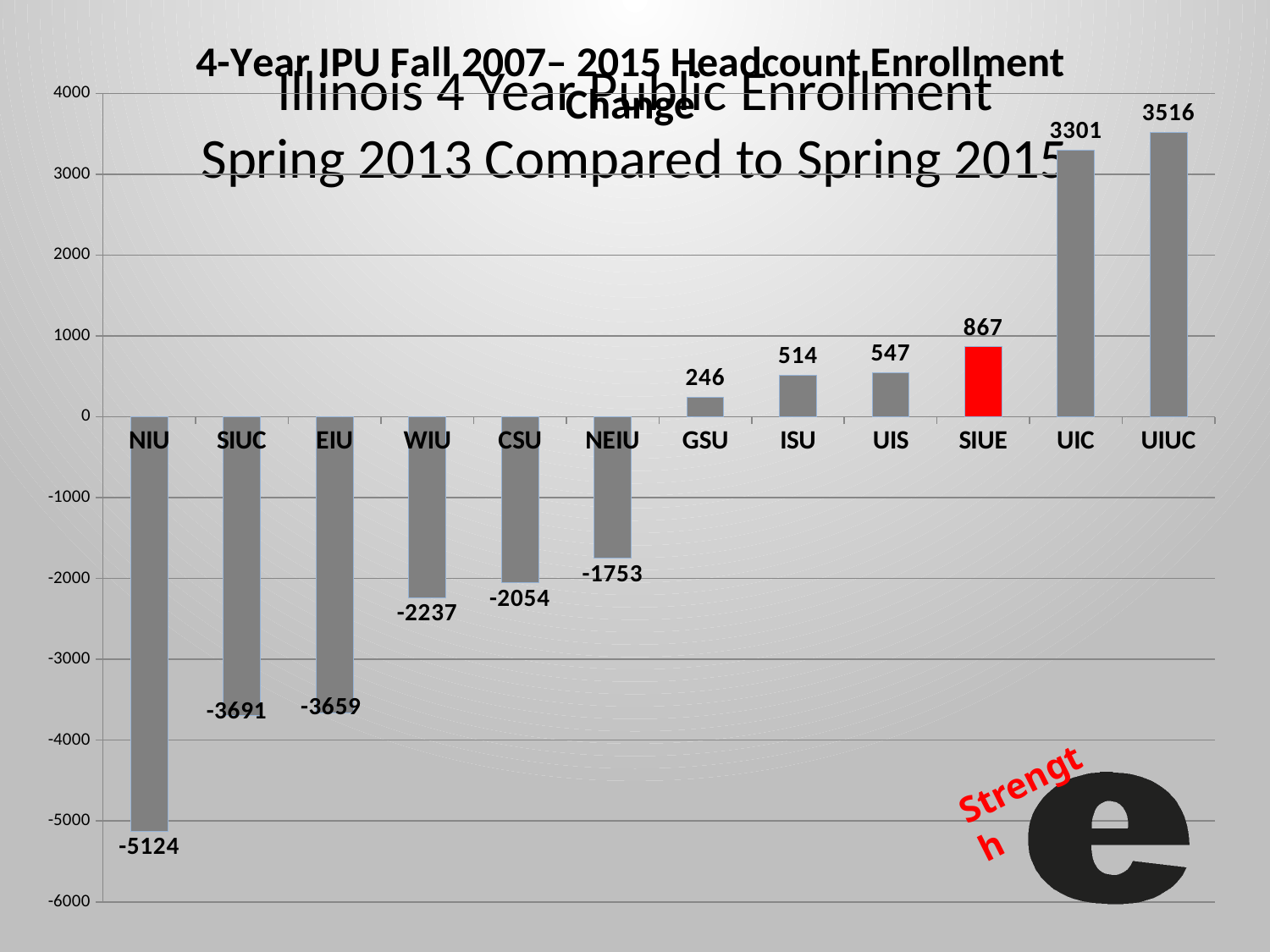
What is the value for NEIU? -1753 Which has a larger value, GSU or SIUE? SIUE What is the difference between the values for UIS and ISU? 33 What is the value for NIU? -5124 What is the value for SIUE? 867 Which institution has the highest value? UIUC What is the difference between the values for UIUC and UIC? 215 Which institution's bar is coloured red? SIUE Which institution has the lowest value? NIU What is the value for UIC? 3301 How many institutions are shown on the x axis? 12 What kind of chart is shown on the slide? Bar chart